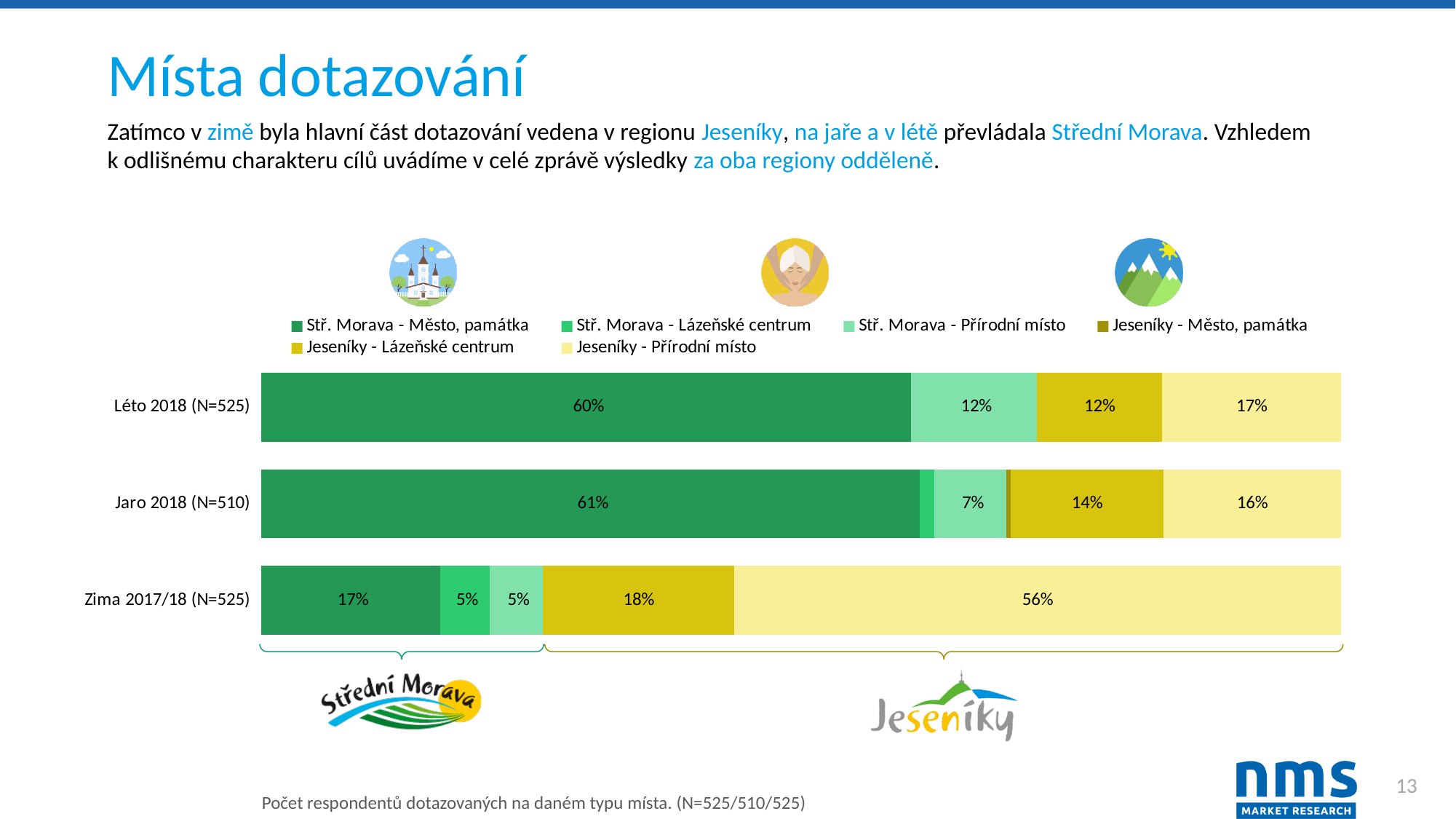
Which is larger: the Jeseníky - Přírodní místo value for Léto 2018 or for Jaro 2018? Léto 2018 How many series does the legend list? 6 What is the value for Stř. Morava - Přírodní místo in the Jaro 2018 (N=510) bar? 7% In the Zima 2017/18 bar, how much larger is the Jeseníky - Přírodní místo value than the Stř. Morava - Město, památka value? 39 percentage points How many periods (bars) are shown in the chart? 3 What kind of chart is shown on the slide? Stacked bar chart What is the value for Jeseníky - Přírodní místo in the Zima 2017/18 (N=525) bar? 56% Which period has the lowest value for Jeseníky - Přírodní místo? Jaro 2018 (N=510) Which period has the highest value for Stř. Morava - Město, památka? Jaro 2018 (N=510) What is the value for Stř. Morava - Město, památka in the Léto 2018 (N=525) bar? 60%